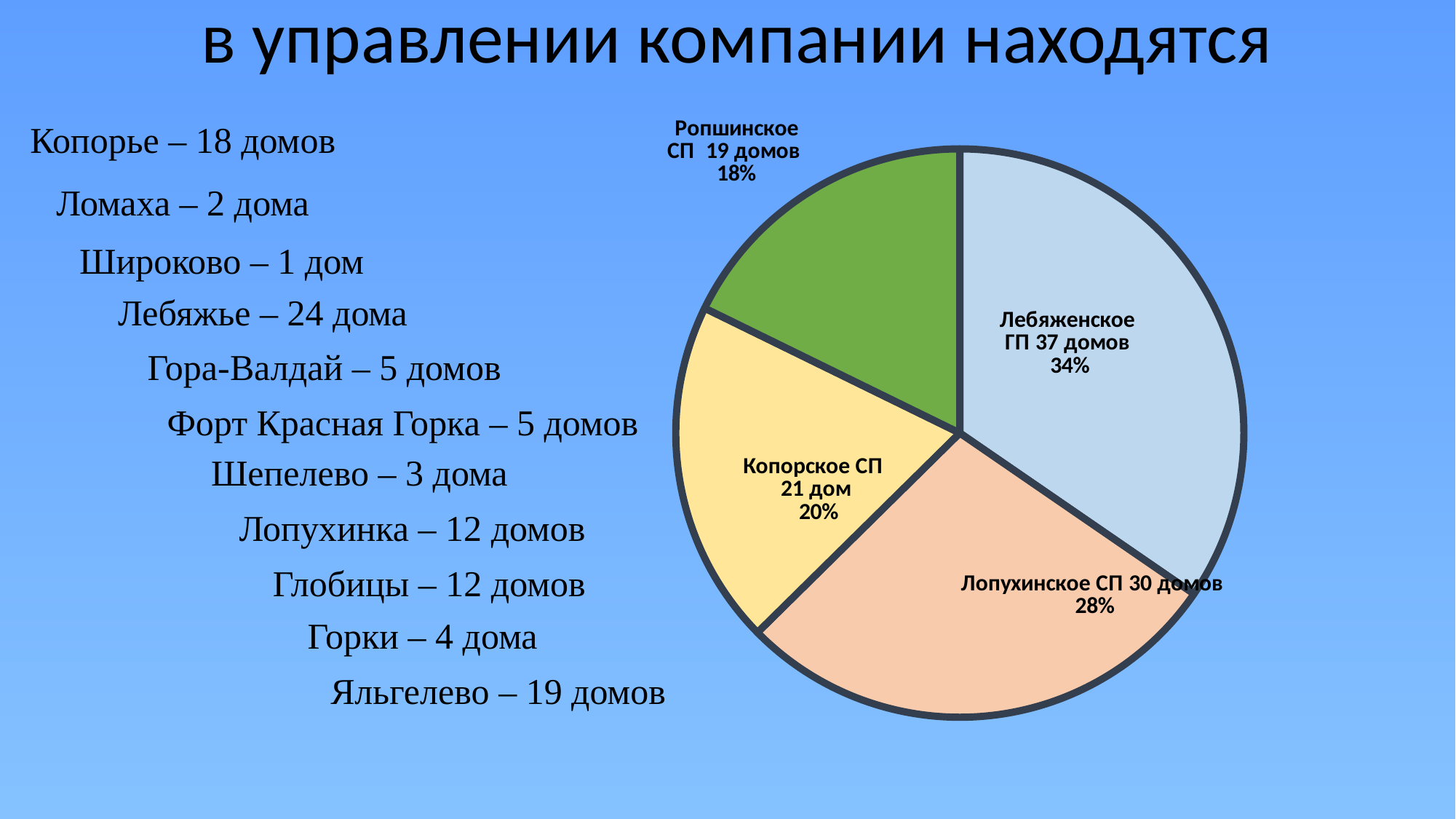
How many more houses does Лебяженское ГП have than Лопухинское СП? 7 Which slice of the pie chart is the largest? Лебяженское ГП How many slices does the pie chart have? 4 What percentage share does the Лебяженское ГП slice have? 34% What kind of chart is shown on the slide? pie chart What colour is the Лопухинское СП slice? orange (peach) How many houses does the Копорское СП slice represent? 21 дом What is the total number of houses across all four slices of the pie chart? 107 How many houses does the Лопухинское СП slice represent? 30 домов Which slice of the pie chart is the smallest? Ропшинское СП What percentage share does the Ропшинское СП slice have? 18% Which has more houses, Копорское СП or Ропшинское СП? Копорское СП